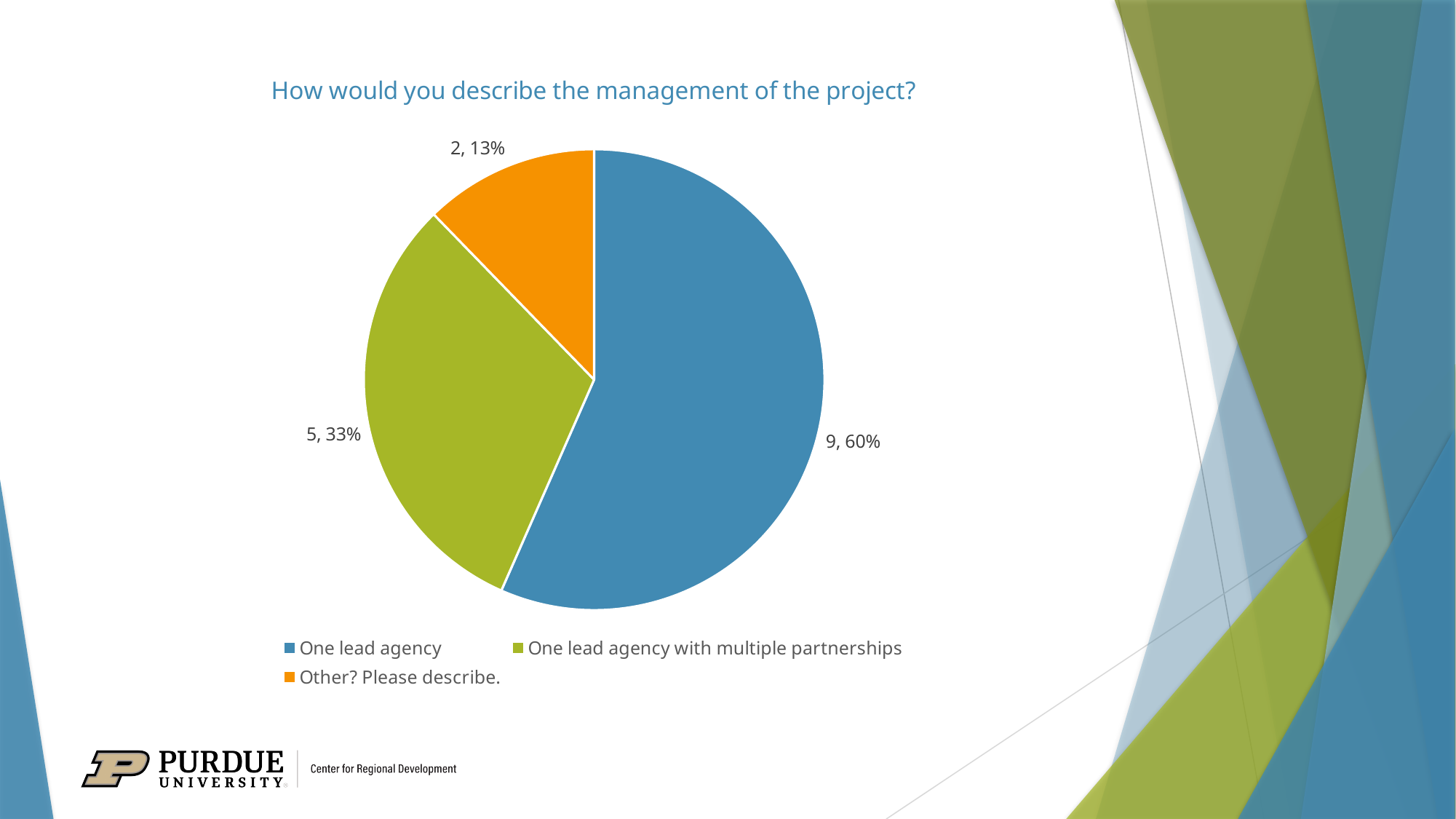
Which category has the smallest slice? Other? Please describe. How many entries does the legend list? 3 What kind of chart is shown on the slide? pie chart What is the difference in count between 'One lead agency' and 'One lead agency with multiple partnerships'? 4 What is the title of the chart? How would you describe the management of the project? What count is shown for the 'One lead agency with multiple partnerships' slice? 5 Which is larger: the count for 'One lead agency with multiple partnerships' or the count for 'Other? Please describe.'? One lead agency with multiple partnerships Which category has the largest slice? One lead agency How many slices does the pie chart have? 3 What count is shown for the 'One lead agency' slice? 9 What percentage share does the 'One lead agency' slice have? 60% What percentage share does the 'Other? Please describe.' slice have? 13%